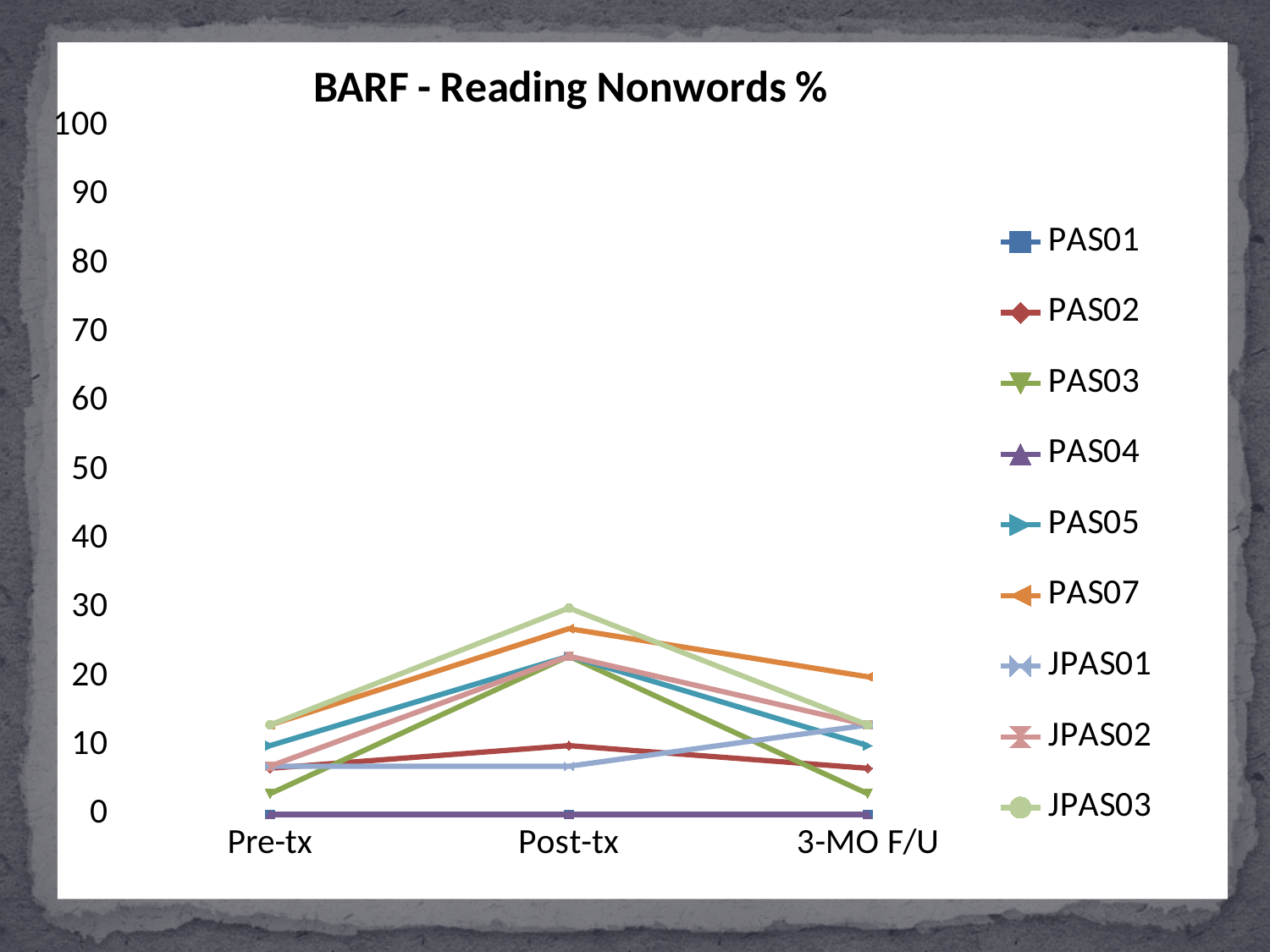
Does the value for PAS03 rise or fall from Pre-tx to Post-tx? rise What is the title of the chart? BARF - Reading Nonwords % Does the value for PAS07 rise or fall from Post-tx to 3-MO F/U? fall Which series has the highest value at 3-MO F/U? PAS07 How many series does the legend list? 9 At 3-MO F/U, which is larger: the value for PAS07 or the value for PAS02? PAS07 Is the value for PAS02 at Post-tx greater or less than 20? less What is the value for PAS01 at Pre-tx? 0 What kind of chart is shown on the slide? line chart Which series has the highest value at Post-tx? JPAS03 How many categories are shown on the x axis? 3 Is the value for PAS07 at Post-tx greater or less than 20? greater